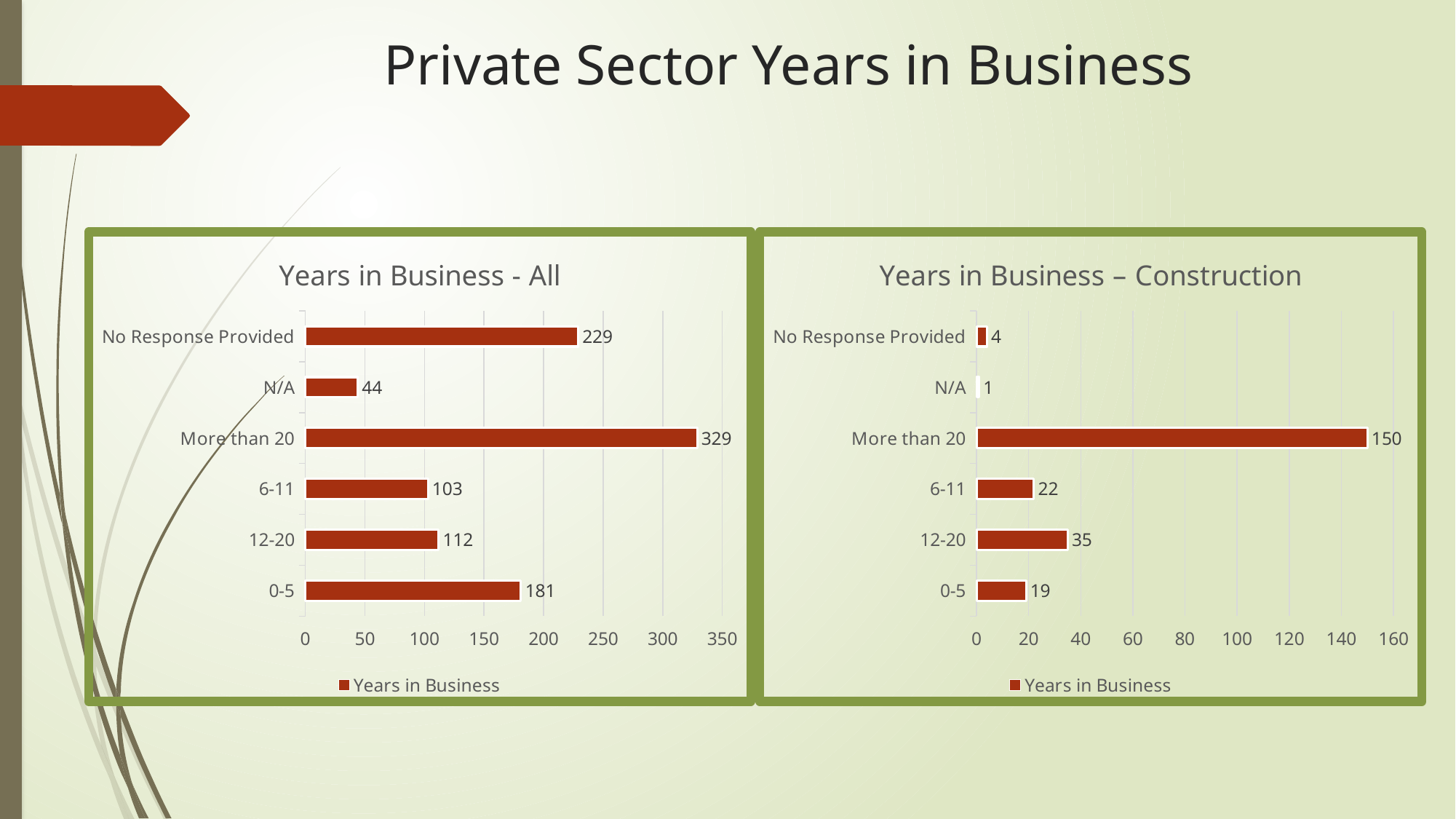
In the 'Years in Business – Construction' chart, which is larger, the value for '6-11' or the value for '0-5'? 6-11 How many series does the legend of the 'Years in Business - All' chart list? 1 In the 'Years in Business - All' chart, which category has the lowest value? N/A How many categories are shown in the 'Years in Business – Construction' chart? 6 In the 'Years in Business – Construction' chart, which category has the highest value? More than 20 In the 'Years in Business - All' chart, is the value for '12-20' greater or less than 100? greater In the 'Years in Business - All' chart, what is the value for 'More than 20'? 329 What is the legend entry shown in the 'Years in Business – Construction' chart? Years in Business In the 'Years in Business – Construction' chart, what is the difference between the values for 'More than 20' and '12-20'? 115 In the 'Years in Business - All' chart, what is the difference between the values for 'No Response Provided' and '0-5'? 48 In the 'Years in Business – Construction' chart, what is the value for '12-20'? 35 What kind of chart is the 'Years in Business – Construction' chart? Bar chart